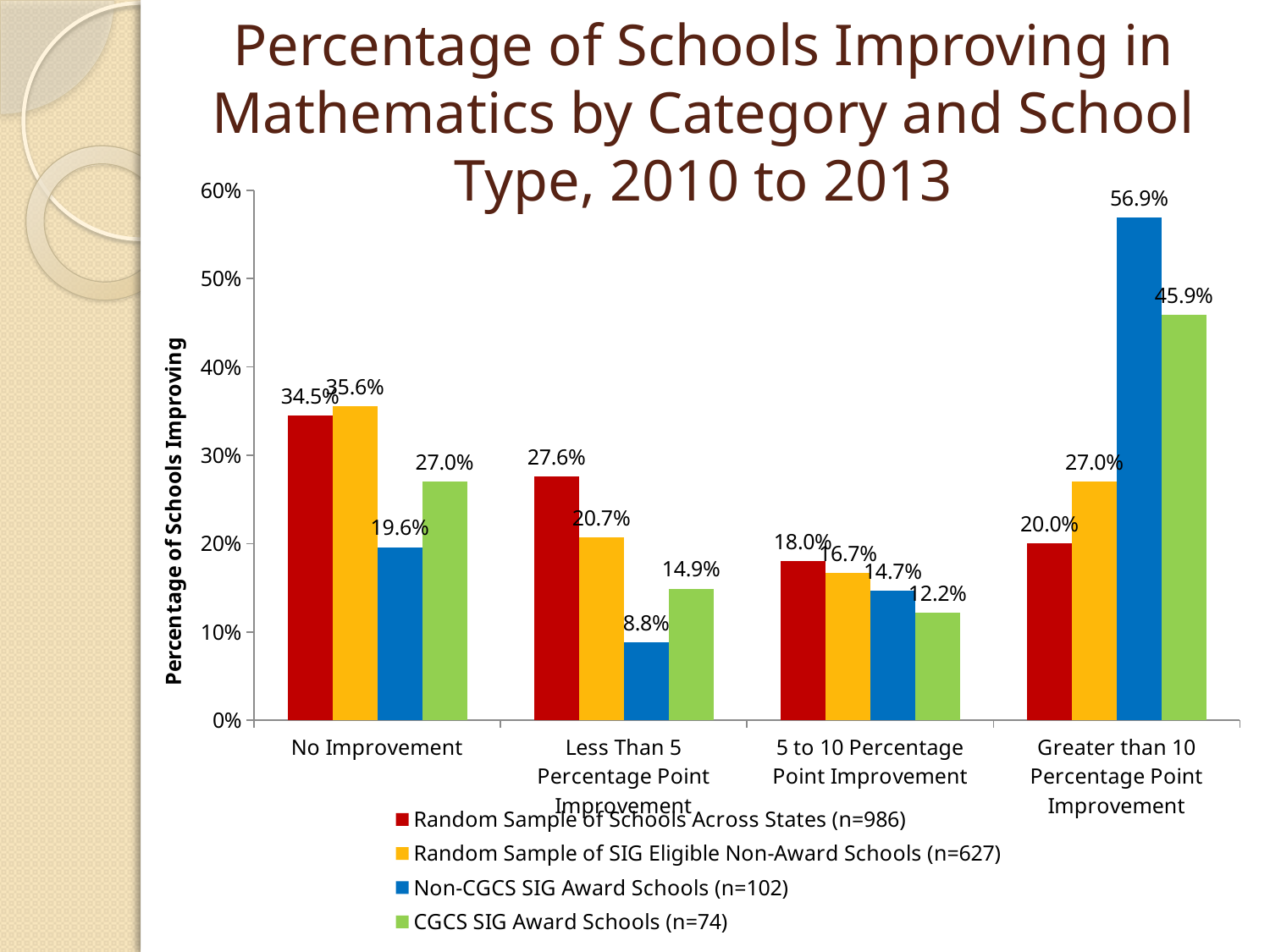
What kind of chart is shown on the slide? Bar chart How many improvement categories are shown on the x axis? 4 What is the value for CGCS SIG Award Schools (n=74) in the No Improvement category? 27.0% What is the label of the vertical axis? Percentage of Schools Improving How many series does the legend list? 4 What is the value for Random Sample of SIG Eligible Non-Award Schools (n=627) in the 5 to 10 Percentage Point Improvement category? 16.7% What percentage of Non-CGCS SIG Award Schools (n=102) showed Greater than 10 Percentage Point Improvement? 56.9% What is the difference between Non-CGCS SIG Award Schools and CGCS SIG Award Schools in the Greater than 10 Percentage Point Improvement category? 11.0% In the No Improvement category, which is larger: the Random Sample of Schools Across States or the Random Sample of SIG Eligible Non-Award Schools? Random Sample of SIG Eligible Non-Award Schools (n=627) Which school type has the lowest value in the Less Than 5 Percentage Point Improvement category? Non-CGCS SIG Award Schools (n=102) What percentage of the Random Sample of Schools Across States (n=986) had Less Than 5 Percentage Point Improvement? 27.6% Which school type has the highest value in the Greater than 10 Percentage Point Improvement category? Non-CGCS SIG Award Schools (n=102)